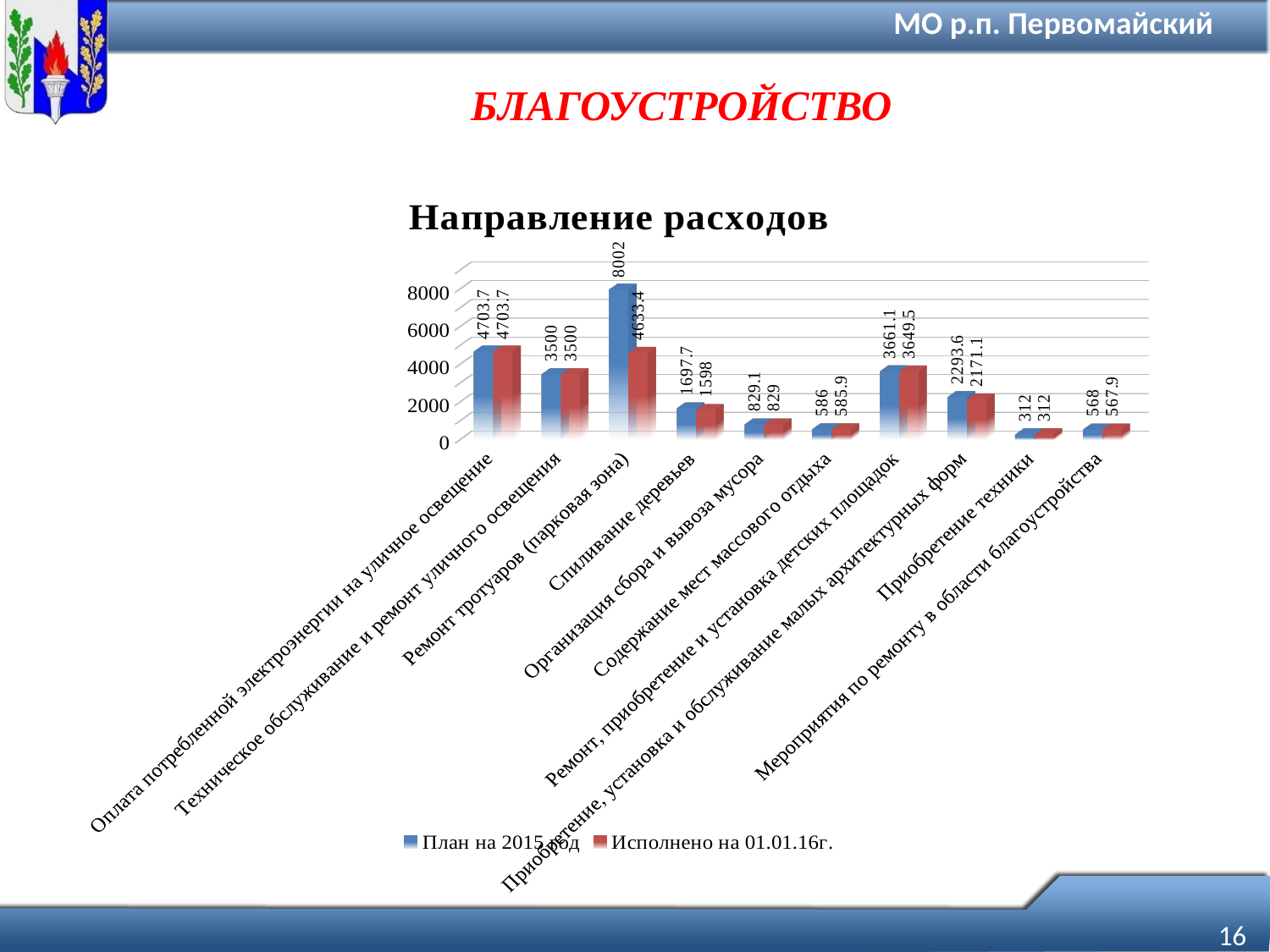
What is the executed value (Исполнено на 01.01.16г.) for Спиливание деревьев? 1598 How many expense categories are shown on the x axis? 10 Which category has the lowest executed value (Исполнено на 01.01.16г.)? Приобретение техники What is the difference between the planned and executed values for Ремонт тротуаров (парковая зона)? 3368.6 Which category has the highest planned value (План на 2015 год)? Ремонт тротуаров (парковая зона) What is the planned value (План на 2015 год) for Ремонт тротуаров (парковая зона)? 8002 What is the planned value (План на 2015 год) for Приобретение, установка и обслуживание малых архитектурных форм? 2293.6 How many series does the legend list? 2 Which is larger for Спиливание деревьев: the planned value or the executed value? The planned value (1697.7) What type of chart is shown on the slide? Bar chart What is the executed value (Исполнено на 01.01.16г.) for Ремонт тротуаров (парковая зона)? 4633.4 What is the title of the chart? Направление расходов